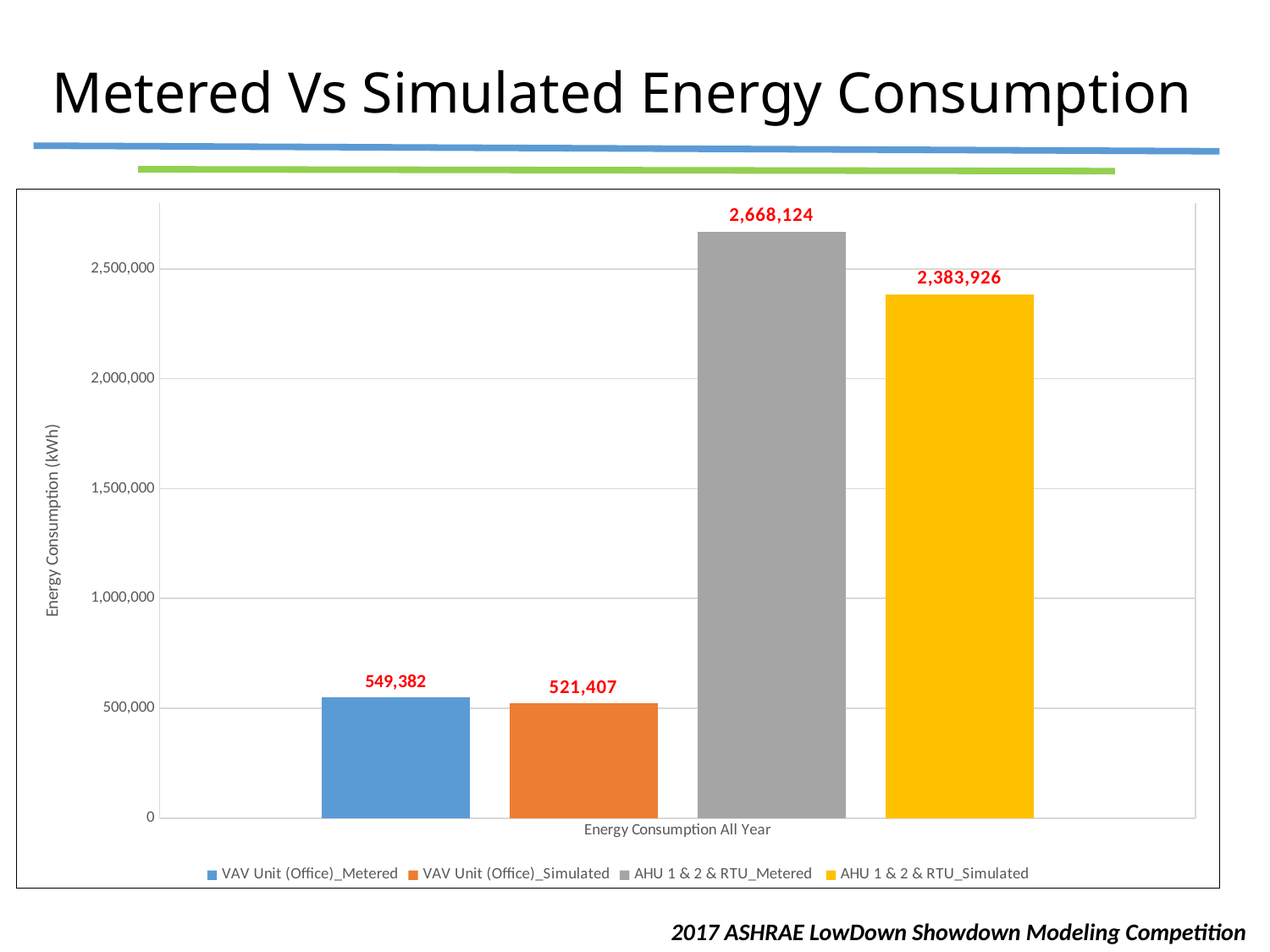
Which is larger, AHU 1 & 2 & RTU_Metered or AHU 1 & 2 & RTU_Simulated? AHU 1 & 2 & RTU_Metered What is the value for VAV Unit (Office)_Simulated? 521,407 Is the value for AHU 1 & 2 & RTU_Simulated greater or less than 2,500,000? less Which series has the highest energy consumption? AHU 1 & 2 & RTU_Metered What is the difference between VAV Unit (Office)_Metered and VAV Unit (Office)_Simulated? 27,975 What is the difference between AHU 1 & 2 & RTU_Metered and AHU 1 & 2 & RTU_Simulated? 284,198 What is the label on the vertical axis of the chart? Energy Consumption (kWh) Which series has the lowest energy consumption? VAV Unit (Office)_Simulated What kind of chart is shown on the slide? Bar chart How many series does the legend list? 4 What is the value for VAV Unit (Office)_Metered? 549,382 What is the value for AHU 1 & 2 & RTU_Simulated? 2,383,926